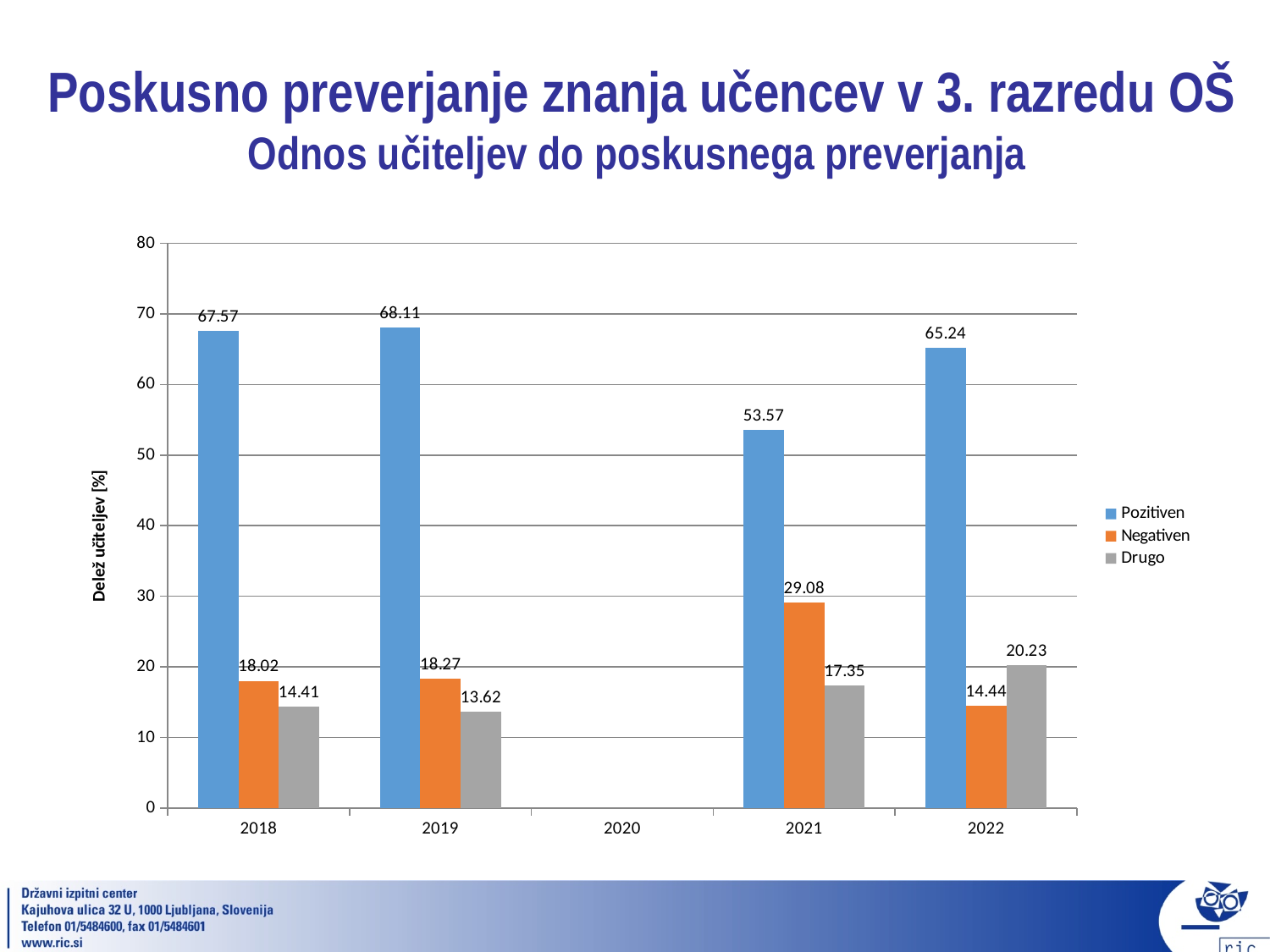
How many series does the legend list? 3 What is the value for Drugo in 2022? 20.23 What kind of chart is shown on the slide? Bar chart What is the difference between the Pozitiven values in 2019 and 2018? 0.54 What is the label of the vertical axis? Delež učiteljev [%] What is the value for Negativen in 2019? 18.27 Which is larger, the Drugo value in 2021 or the Negativen value in 2022? Drugo in 2021 In which year is the Drugo value lowest? 2019 In which year is the Negativen value highest? 2021 What is the difference between the Negativen values in 2021 and 2018? 11.06 In which year is the Pozitiven value lowest? 2021 What is the value for Pozitiven in 2021? 53.57